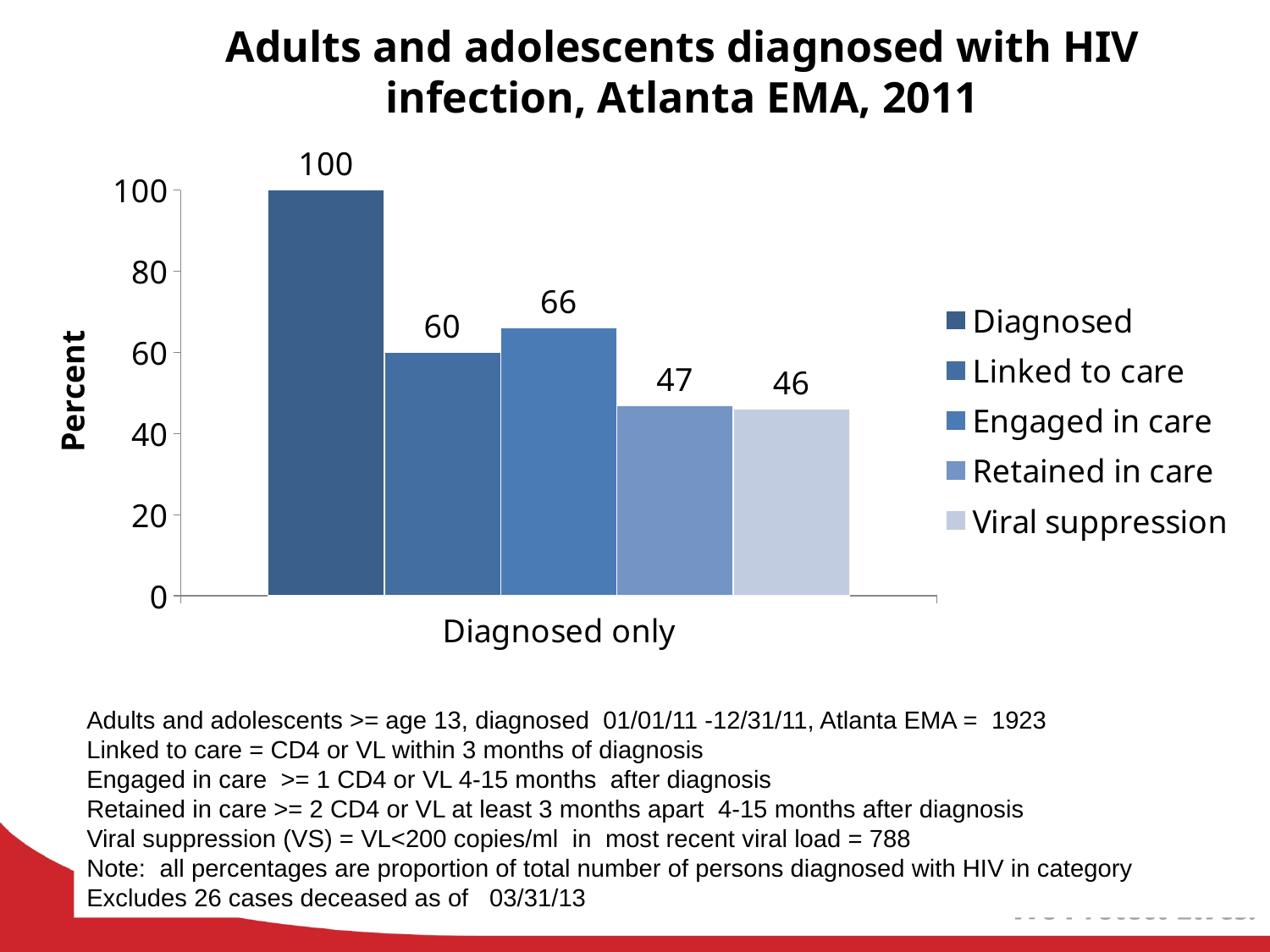
What is the value for Viral suppression? 46 What kind of chart is shown on the slide? Bar chart What is the value for Engaged in care? 66 What is the label on the vertical axis of the chart? Percent Which series has the highest value? Diagnosed Which is larger, the value for Linked to care or the value for Engaged in care? Engaged in care What is the difference between the Engaged in care value and the Retained in care value? 19 What is the difference between the Diagnosed value and the Linked to care value? 40 What is the value for Retained in care? 47 Which series has the lowest value? Viral suppression How many series does the legend list? 5 What is the value for Linked to care? 60